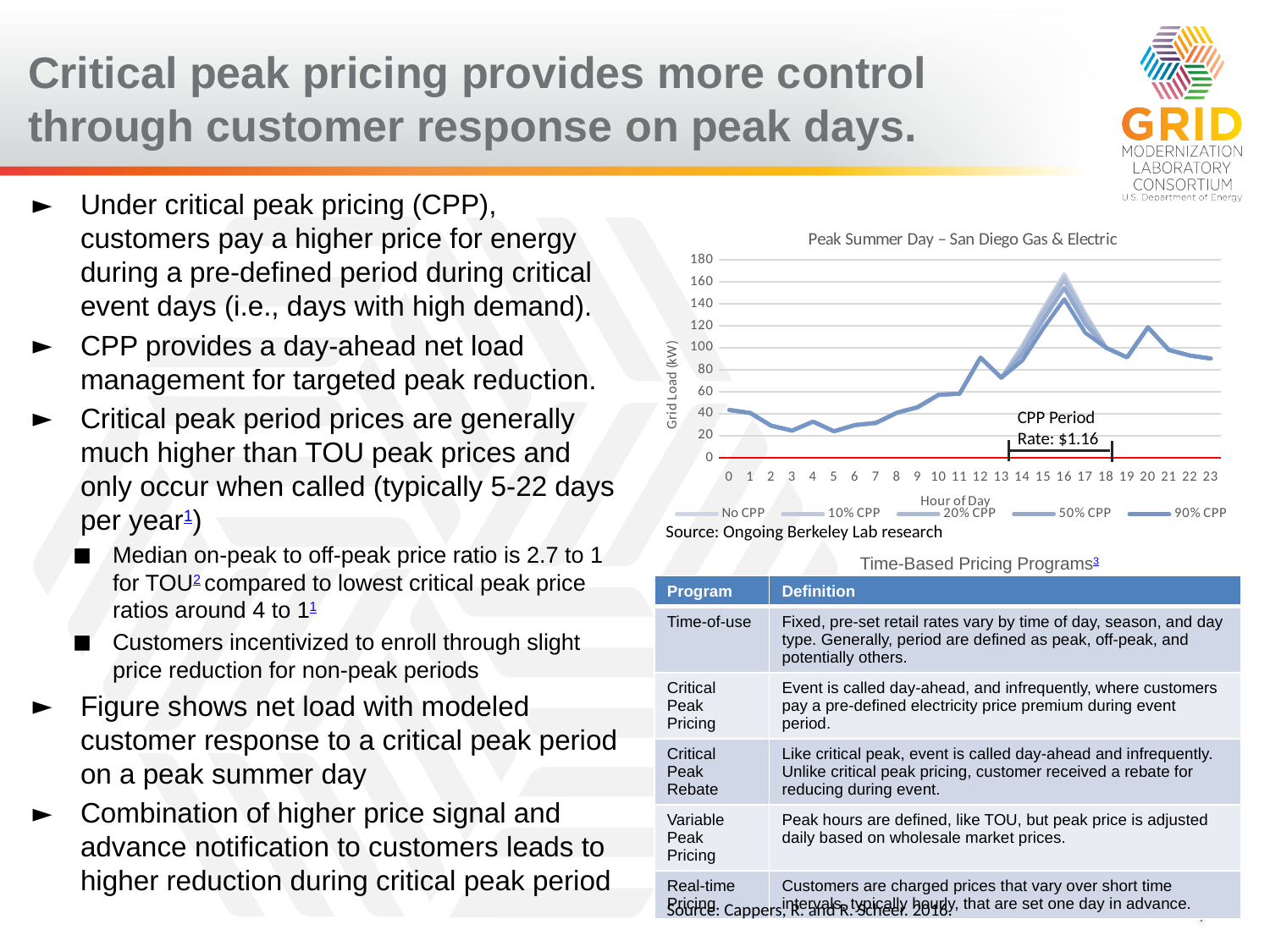
How many hours of the day are plotted along the x axis? 24 Does the grid load rise or fall between hour 16 and hour 19? fall Is the No CPP grid load at hour 16 greater or less than 140? greater Is the grid load at hour 9 greater or less than 60? less At which hour of the day does the grid load reach its highest value? 16 Is the grid load at hour 3 greater or less than 40? less Does the grid load rise or fall between hour 5 and hour 12? rise What is the title of the chart? Peak Summer Day – San Diego Gas & Electric What rate is shown for the CPP Period annotation on the chart? $1.16 How many series does the chart legend list? 5 What kind of chart is shown on the slide? line chart